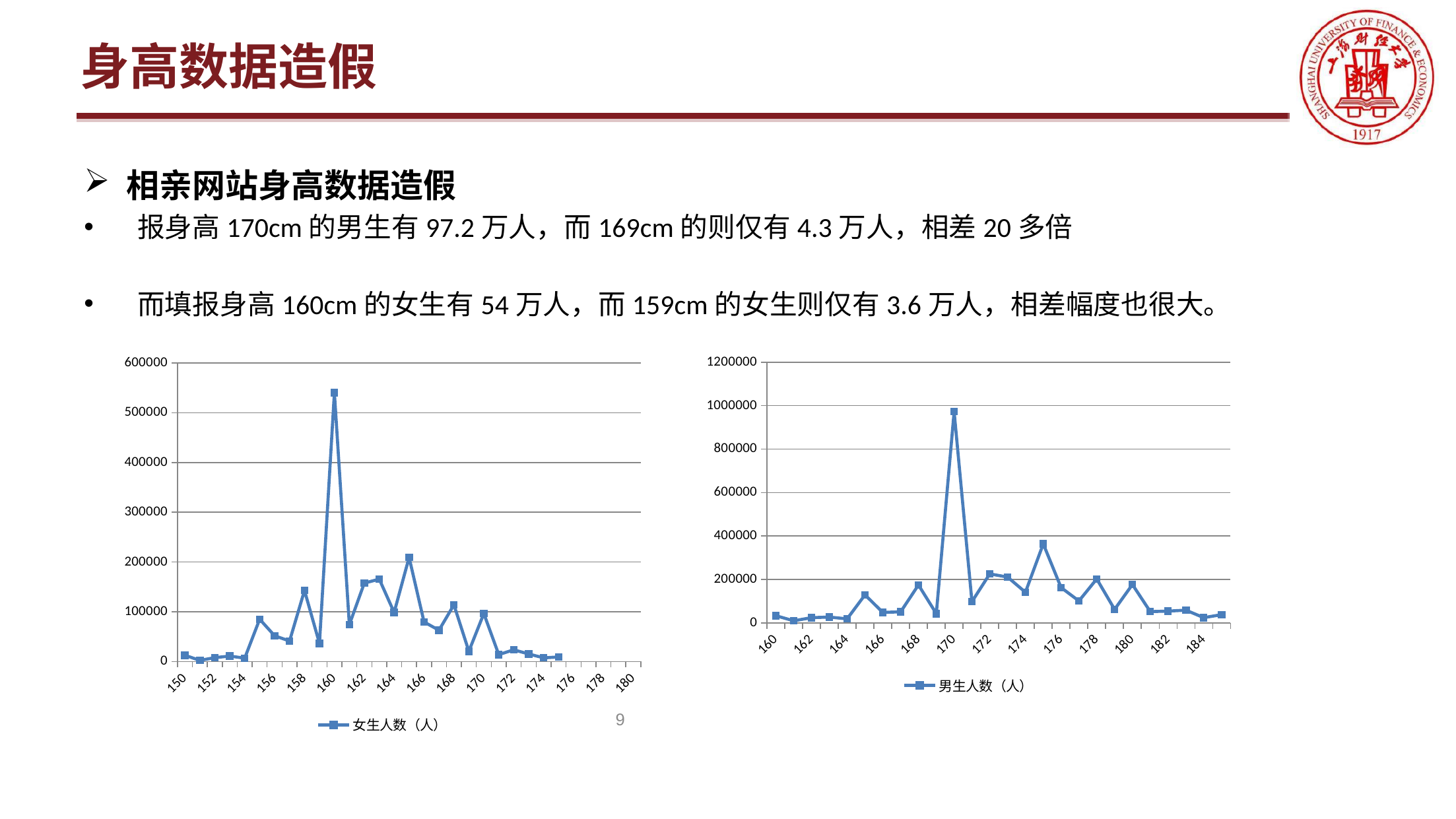
In the left chart (女生人数), is the value at 160 greater or less than 500000? greater What kind of chart is the right chart (男生人数)? line chart In the right chart (男生人数), which is larger, the value at 176 or the value at 177? 176 In the right chart (男生人数), is the value at 175 greater or less than 400000? less In the left chart (女生人数), is the value at 158 greater or less than 100000? greater What is the legend entry of the left chart? 女生人数（人） How many series does the legend of the right chart list? 1 In the left chart (女生人数), at which height is the number of people highest? 160 In the right chart (男生人数), at which height is the number of people highest? 170 In the left chart (女生人数), which is larger, the value at 160 or the value at 165? 160 What kind of chart is the left chart (女生人数)? line chart